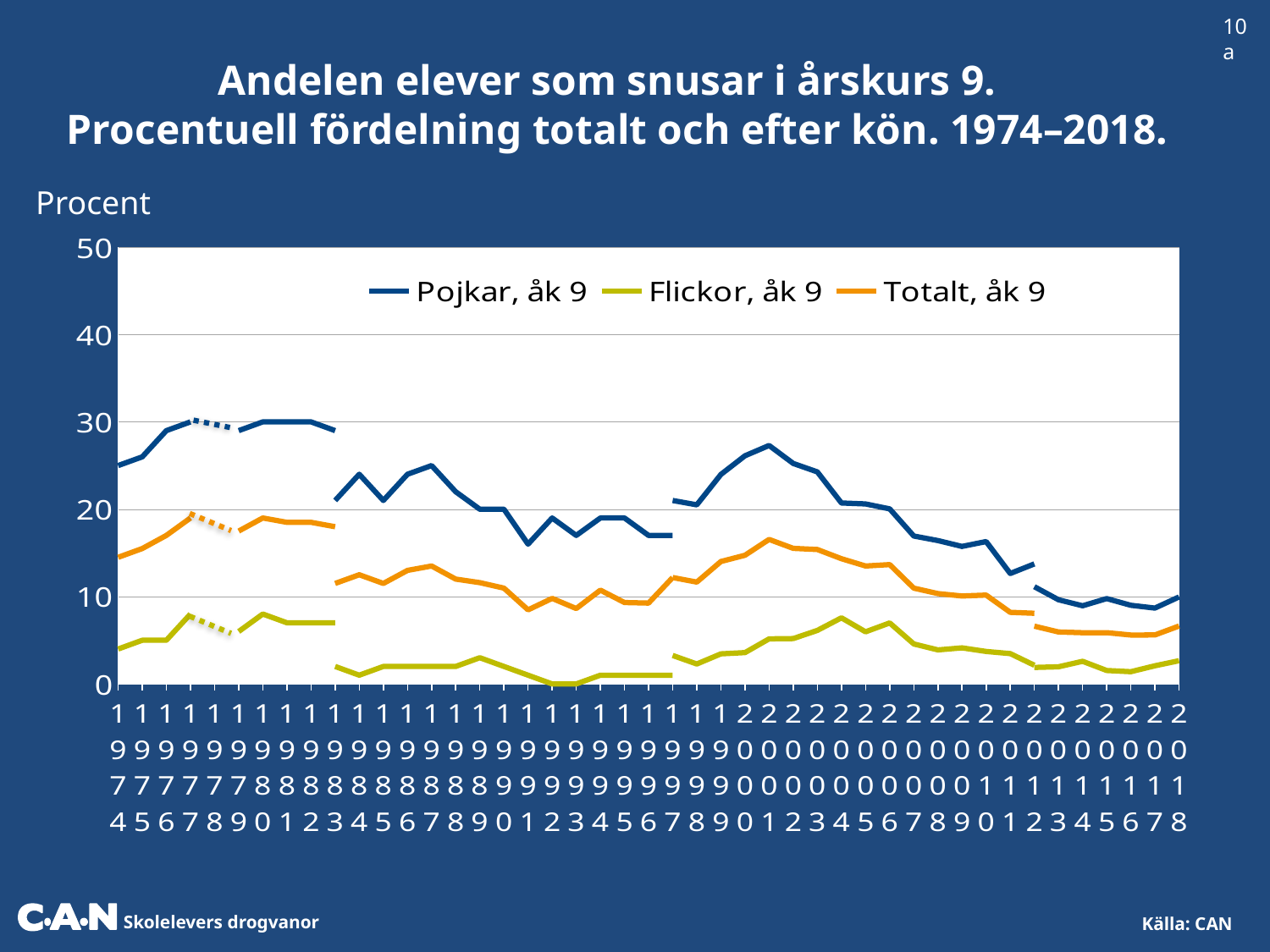
Is the value for Pojkar, åk 9 in 2002 greater or less than 20? greater What kind of chart is shown on the slide? line chart Is the value for Totalt, åk 9 in 2018 greater or less than 10? less What is the label on the y axis of the chart? Procent Which is larger in 2002, the value for Pojkar, åk 9 or the value for Flickor, åk 9? Pojkar, åk 9 Is the value for Pojkar, åk 9 in 1974 greater or less than 20? greater How many series does the legend list? 3 Which series has the highest value in 2002? Pojkar, åk 9 Which series is drawn in orange? Totalt, åk 9 Does the value for Pojkar, åk 9 rise or fall from 2002 to 2018? fall